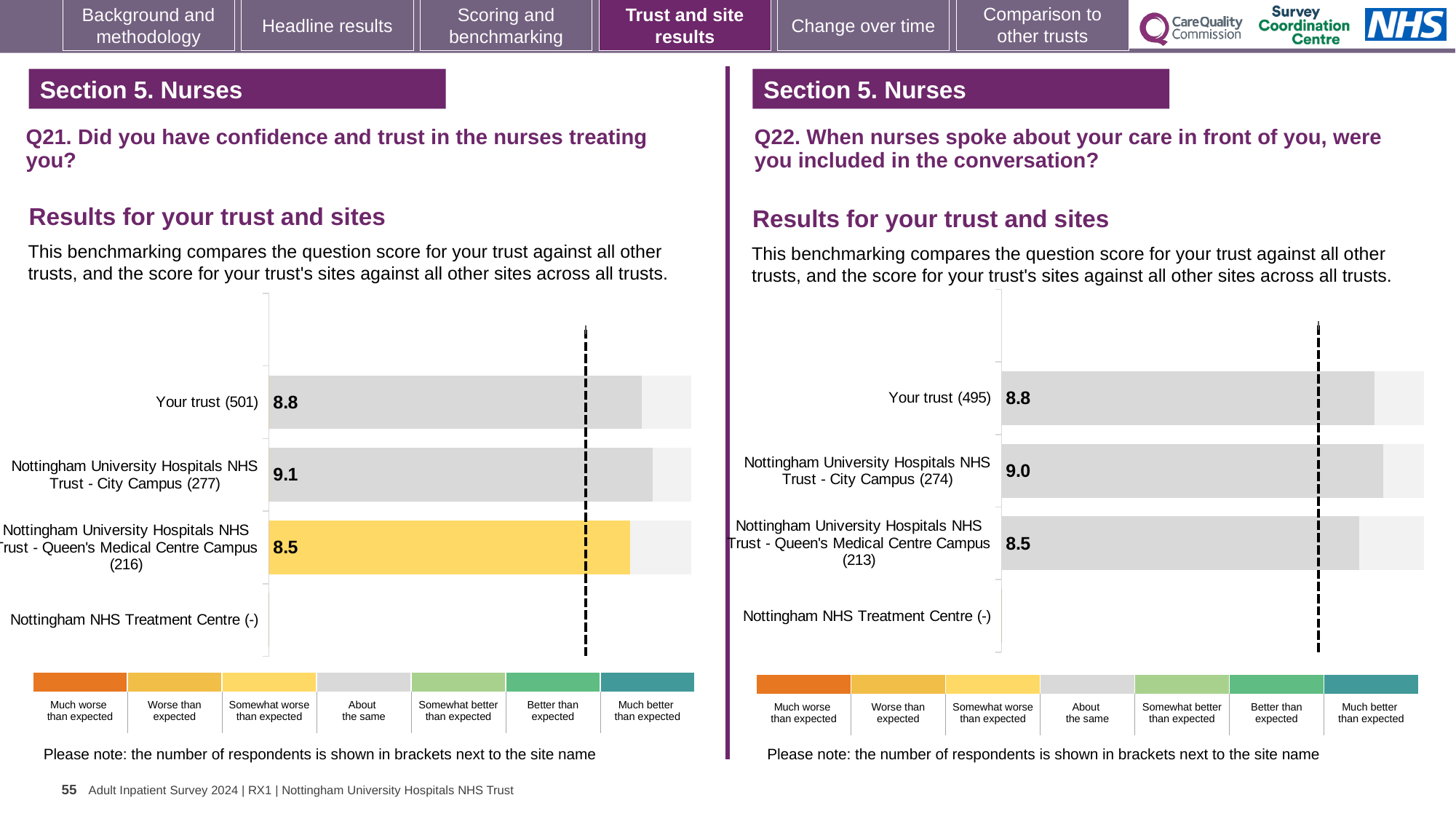
On the Q21 chart (left), what is the score for Nottingham University Hospitals NHS Trust - Queen's Medical Centre Campus (216)? 8.5 On the Q21 chart (left), what is the score for Nottingham University Hospitals NHS Trust - City Campus (277)? 9.1 On the Q22 chart (right), what is the difference between the Your trust score and the Queen's Medical Centre Campus score? 0.3 What kind of chart is used on the Q22 chart (right)? bar chart On the Q21 chart (left), which bar is coloured yellow rather than grey? Nottingham University Hospitals NHS Trust - Queen's Medical Centre Campus (216) On the Q22 chart (right), what is the score for Nottingham University Hospitals NHS Trust - City Campus (274)? 9.0 On the Q21 chart (left), what is the score for Your trust (501)? 8.8 On the Q22 chart (right), what is the score for Your trust (495)? 8.8 On the Q22 chart (right), is the score for Your trust (495) larger or smaller than the score for City Campus (274)? smaller On the Q21 chart (left), which site or trust has the highest score? Nottingham University Hospitals NHS Trust - City Campus (277) On the Q22 chart (right), which site or trust has the lowest score among those with a value shown? Nottingham University Hospitals NHS Trust - Queen's Medical Centre Campus (213) On the Q21 chart (left), what is the difference between the City Campus score and the Queen's Medical Centre Campus score? 0.6